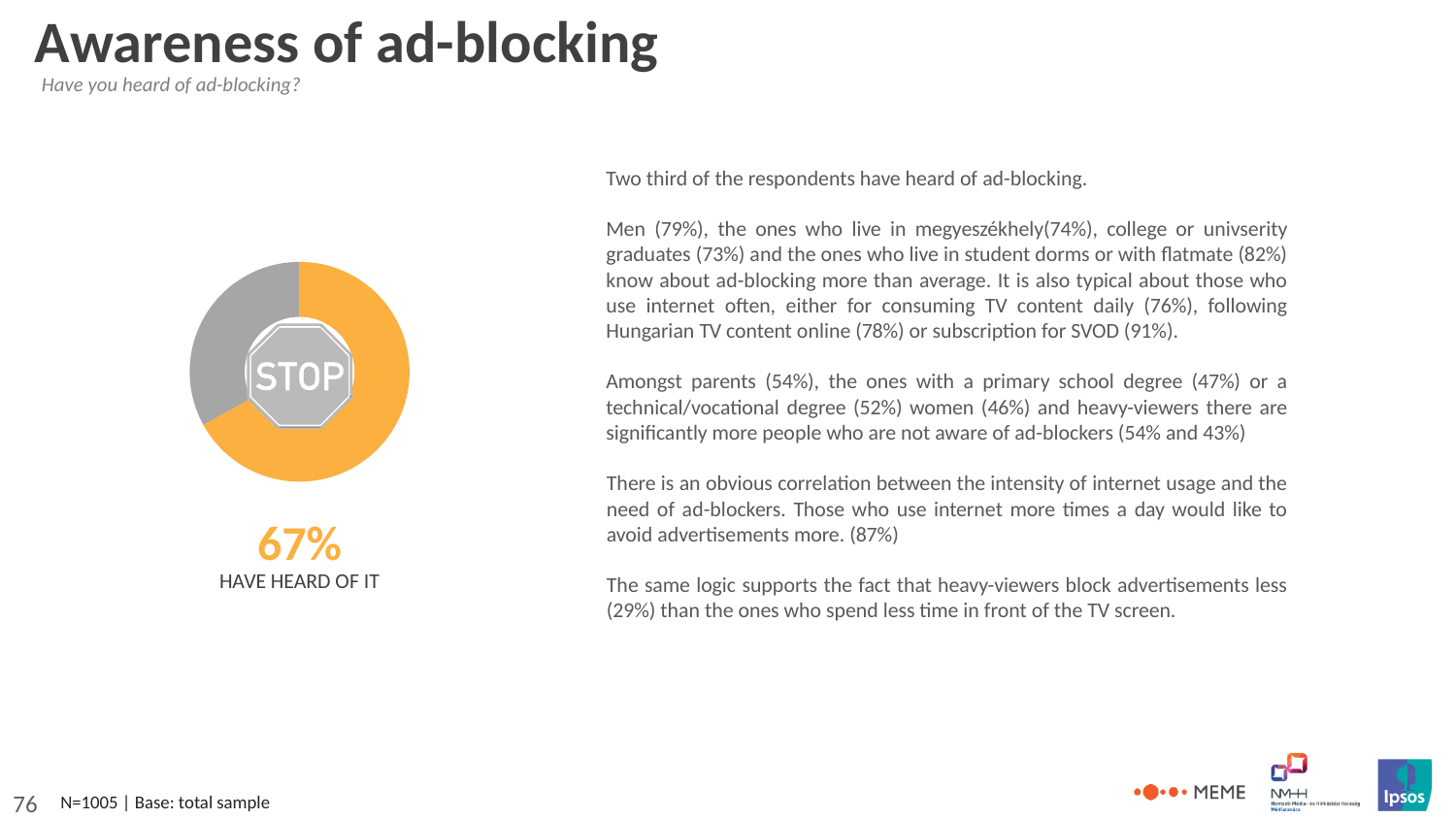
What percentage of respondents have heard of ad-blocking according to the chart? 67% How many slices does the donut chart have? 2 What share of the pie does the 'Have heard of it' slice represent? 67% Which slice of the donut chart is larger, the orange one or the grey one? The orange one What kind of chart is shown on the slide? Pie (donut) chart What colour is the slice representing respondents who have heard of ad-blocking? Orange What is the title of the slide containing the chart? Awareness of ad-blocking Which segment of the chart is the largest? Have heard of it (67%) Is the share of respondents who have heard of ad-blocking greater or less than 50%? greater